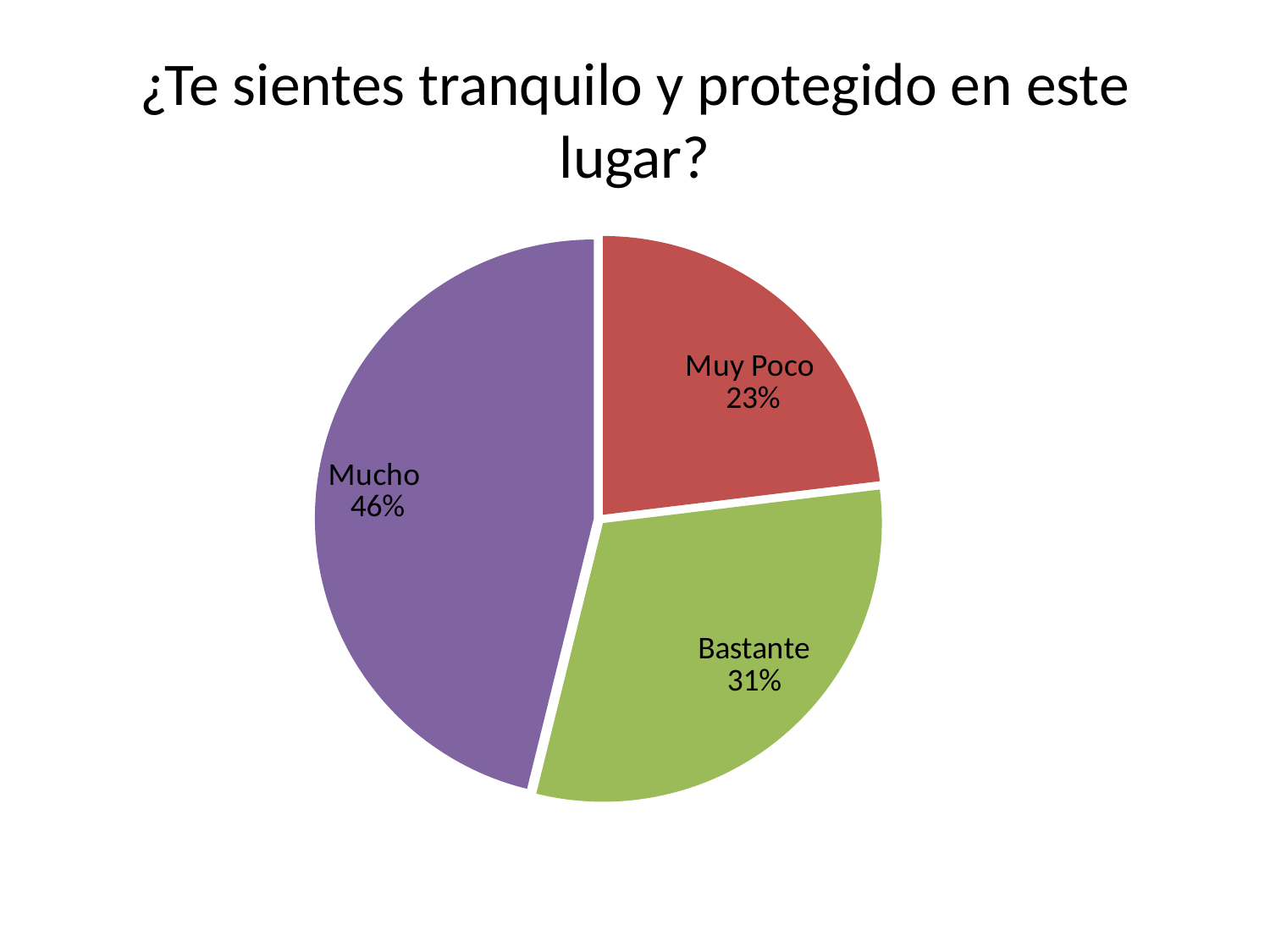
What share of the pie does "Bastante" represent? 31% How many slices does the pie chart have? 3 What kind of chart is shown on the slide? pie chart Which category has the largest slice of the pie? Mucho What share of the pie does "Mucho" represent? 46% Which is larger, the share for "Bastante" or the share for "Muy Poco"? Bastante What is the difference in percentage points between "Bastante" and "Muy Poco"? 8 What is the difference in percentage points between "Mucho" and "Bastante"? 15 Which category has the smallest slice of the pie? Muy Poco What share of the pie does "Muy Poco" represent? 23% What is the title of the chart? ¿Te sientes tranquilo y protegido en este lugar? What colour is the "Mucho" slice? purple